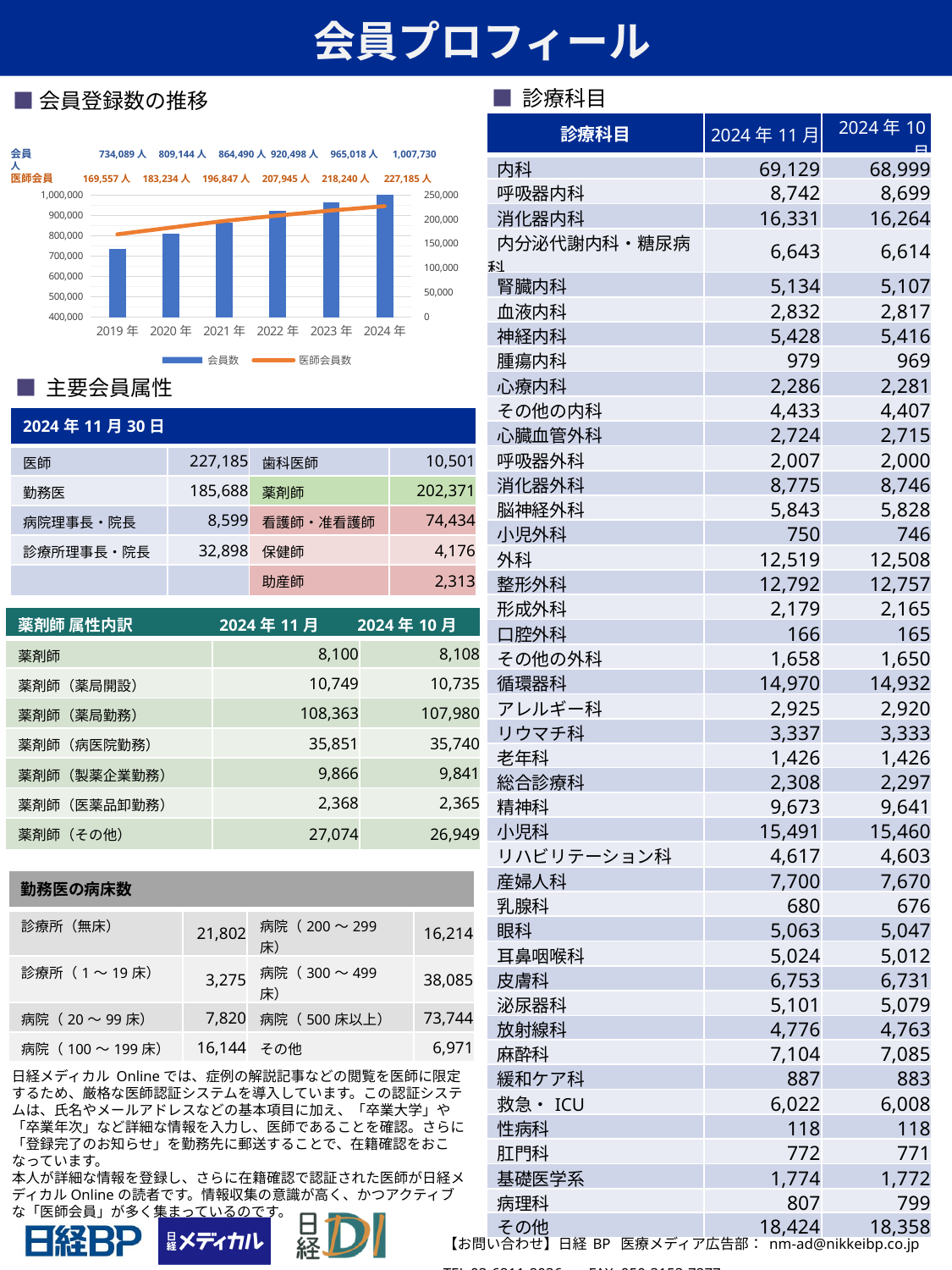
In the 会員登録数の推移 chart, is the 会員 value for 2021年 larger or smaller than the 会員 value for 2023年? smaller In the 会員登録数の推移 chart, what is the 会員 value for 2019年? 734,089人 In the 会員登録数の推移 chart, do the 会員 values rise or fall from 2019年 to 2024年? rise How many series does the legend of the 会員登録数の推移 chart list? 2 In the 会員登録数の推移 chart, what is the 医師会員 value for 2024年? 227,185人 In the 会員登録数の推移 chart, what is the 会員 value for 2022年? 920,498人 In the 会員登録数の推移 chart, what is the difference between the 会員 values for 2023年 and 2022年? 44,520人 In the 会員登録数の推移 chart, which year has the highest 会員 value? 2024年 How many years are shown on the x axis of the 会員登録数の推移 chart? 6 In the 会員登録数の推移 chart, what is the difference between the 医師会員 values for 2020年 and 2019年? 13,677人 In the 会員登録数の推移 chart, what is the 医師会員 value for 2021年? 196,847人 In the 会員登録数の推移 chart, which year has the lowest 医師会員 value? 2019年